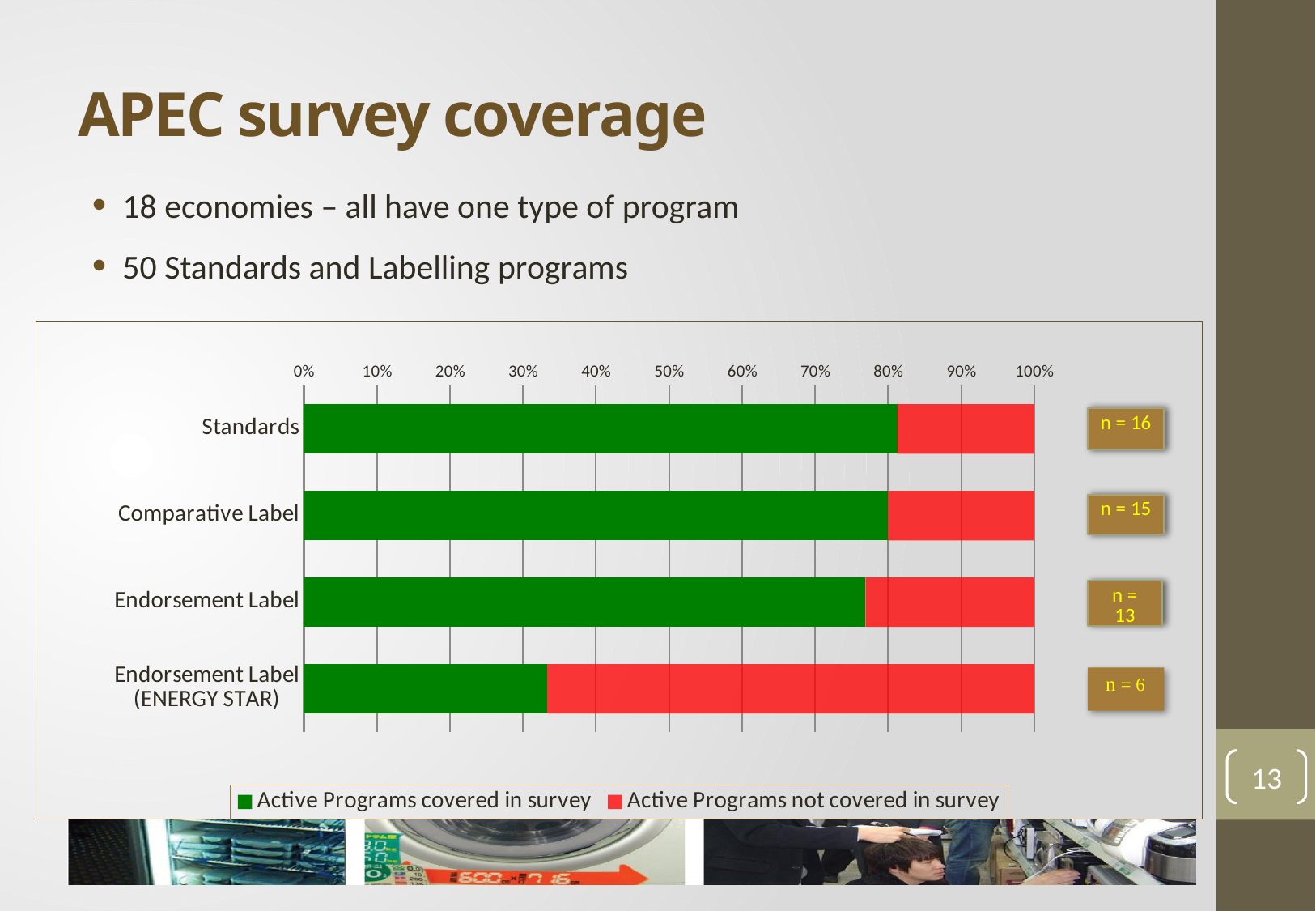
How many categories are shown on the chart's vertical axis? 4 Which has a larger share of Active Programs covered in survey, Endorsement Label or Endorsement Label (ENERGY STAR)? Endorsement Label What kind of chart is shown on the slide? stacked bar chart Which category has the lowest share of Active Programs covered in survey? Endorsement Label (ENERGY STAR) What is the n value shown next to the Standards bar? n = 16 What is the n value shown next to the Comparative Label bar? n = 15 Which colour represents Active Programs not covered in survey in the legend? red What is the n value shown next to the Endorsement Label bar? n = 13 How many series does the chart legend list? 2 What is the n value shown next to the Endorsement Label (ENERGY STAR) bar? n = 6 Is the share of Active Programs covered in survey for Endorsement Label greater or less than 70%? greater Is the share of Active Programs covered in survey for Endorsement Label (ENERGY STAR) greater or less than 40%? less